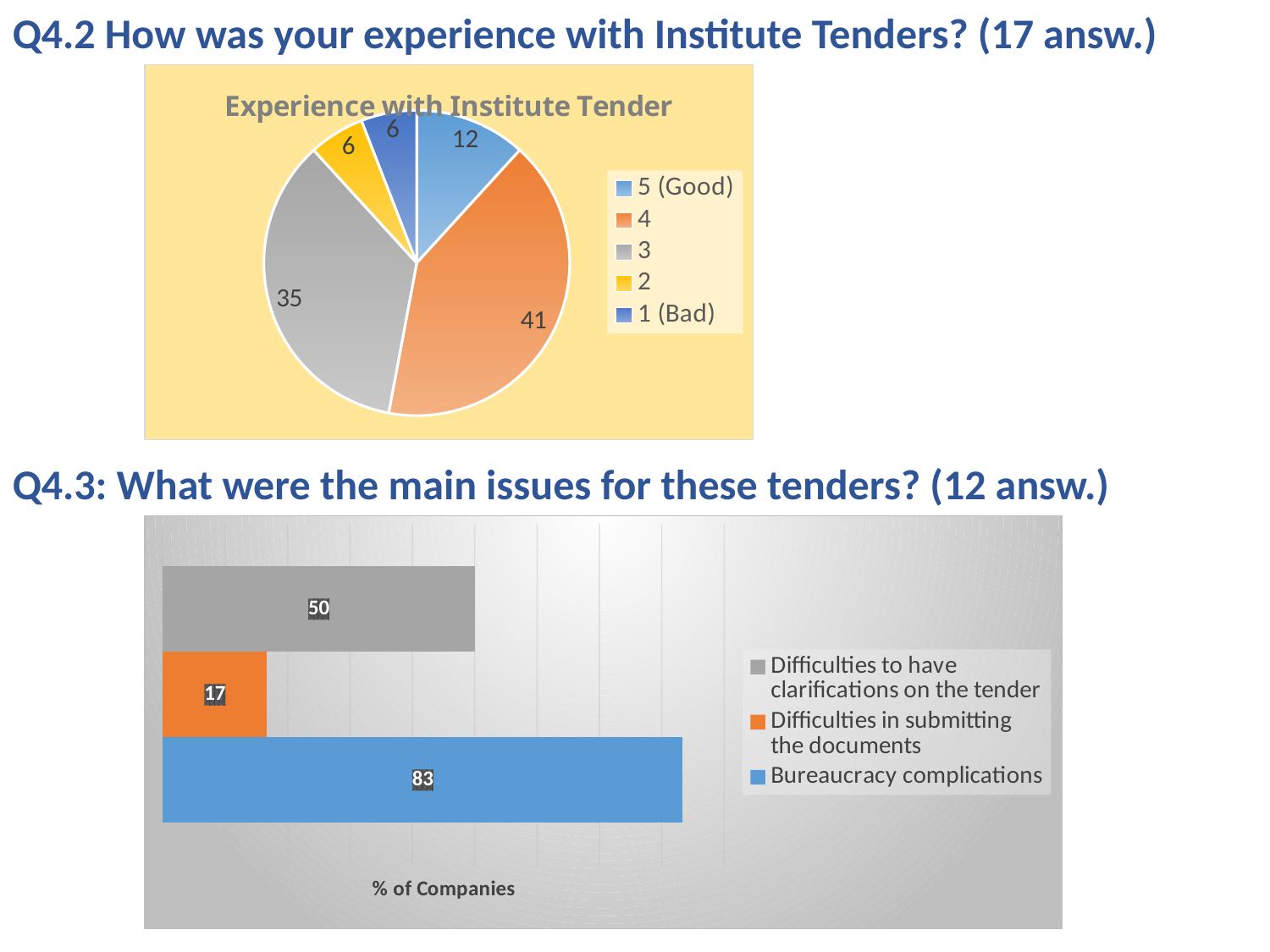
In the Q4.3 chart at the bottom of the slide, what value is shown for 'Difficulties in submitting the documents'? 17 In the 'Experience with Institute Tender' pie chart, what value is shown for the '5 (Good)' slice? 12 In the 'Experience with Institute Tender' pie chart, which category has the largest slice? 4 How many categories does the legend of the 'Experience with Institute Tender' pie chart list? 5 In the 'Experience with Institute Tender' pie chart, what value is shown for the '4' slice? 41 What kind of chart is used for Q4.2 'Experience with Institute Tender'? Pie chart What kind of chart is used for Q4.3 at the bottom of the slide? Bar chart In the 'Experience with Institute Tender' pie chart, which is larger, the value for '3' or the value for '5 (Good)'? 3 In the Q4.3 chart at the bottom of the slide, what is the difference between 'Bureaucracy complications' and 'Difficulties to have clarifications on the tender'? 33 In the Q4.3 chart at the bottom of the slide, which issue has the lowest value? Difficulties in submitting the documents In the Q4.3 chart at the bottom of the slide, what value is shown for 'Bureaucracy complications'? 83 In the 'Experience with Institute Tender' pie chart, what is the difference between the values for '4' and '3'? 6